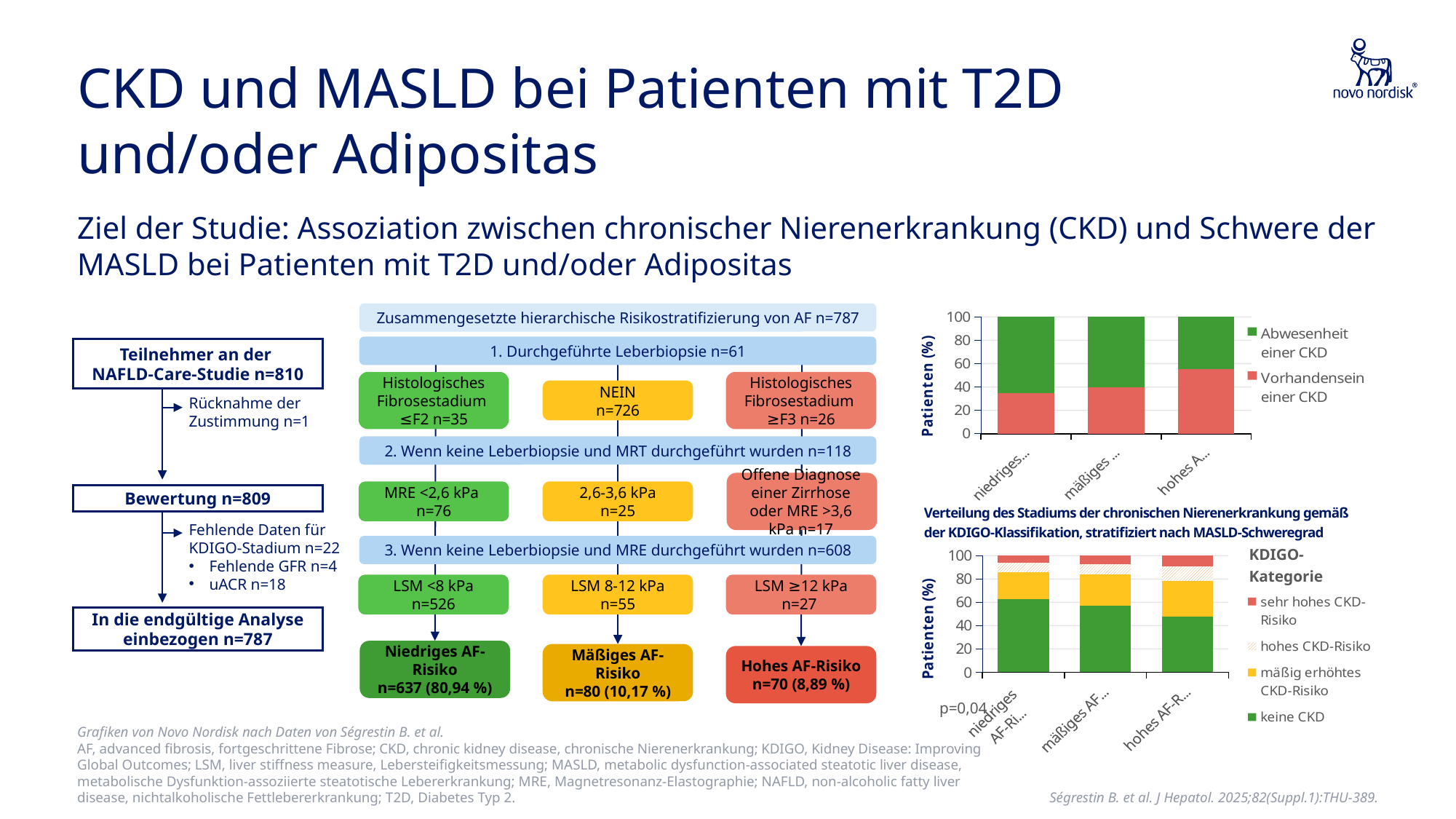
In the top chart on the right, is the value for 'Vorhandensein einer CKD' in the 'hohes' category greater or less than 40? greater In the bottom chart 'Verteilung des Stadiums der chronischen Nierenerkrankung...', which category has the smallest share of 'keine CKD'? hohes AF-Risiko What is the y-axis label of the bottom chart on the right? Patienten (%) In the bottom chart 'Verteilung des Stadiums der chronischen Nierenerkrankung...', which colour represents 'keine CKD'? green How many series does the legend of the bottom chart 'Verteilung des Stadiums der chronischen Nierenerkrankung...' list? 4 How many series does the legend of the top chart on the right list? 2 In the top chart on the right, does the share of 'Vorhandensein einer CKD' rise or fall from the 'niedriges' category to the 'hohes' category? rise In the top chart on the right, is the value for 'Vorhandensein einer CKD' in the 'niedriges' category greater or less than 40? less In the top chart on the right, which category has the largest share of 'Vorhandensein einer CKD'? hohes How many categories are shown on the x axis of the top chart on the right? 3 What kind of chart is the top chart on the right side of the slide? bar chart In the bottom chart 'Verteilung des Stadiums der chronischen Nierenerkrankung...', is the value for 'keine CKD' in the 'hohes AF-Risiko' category greater or less than 60? less